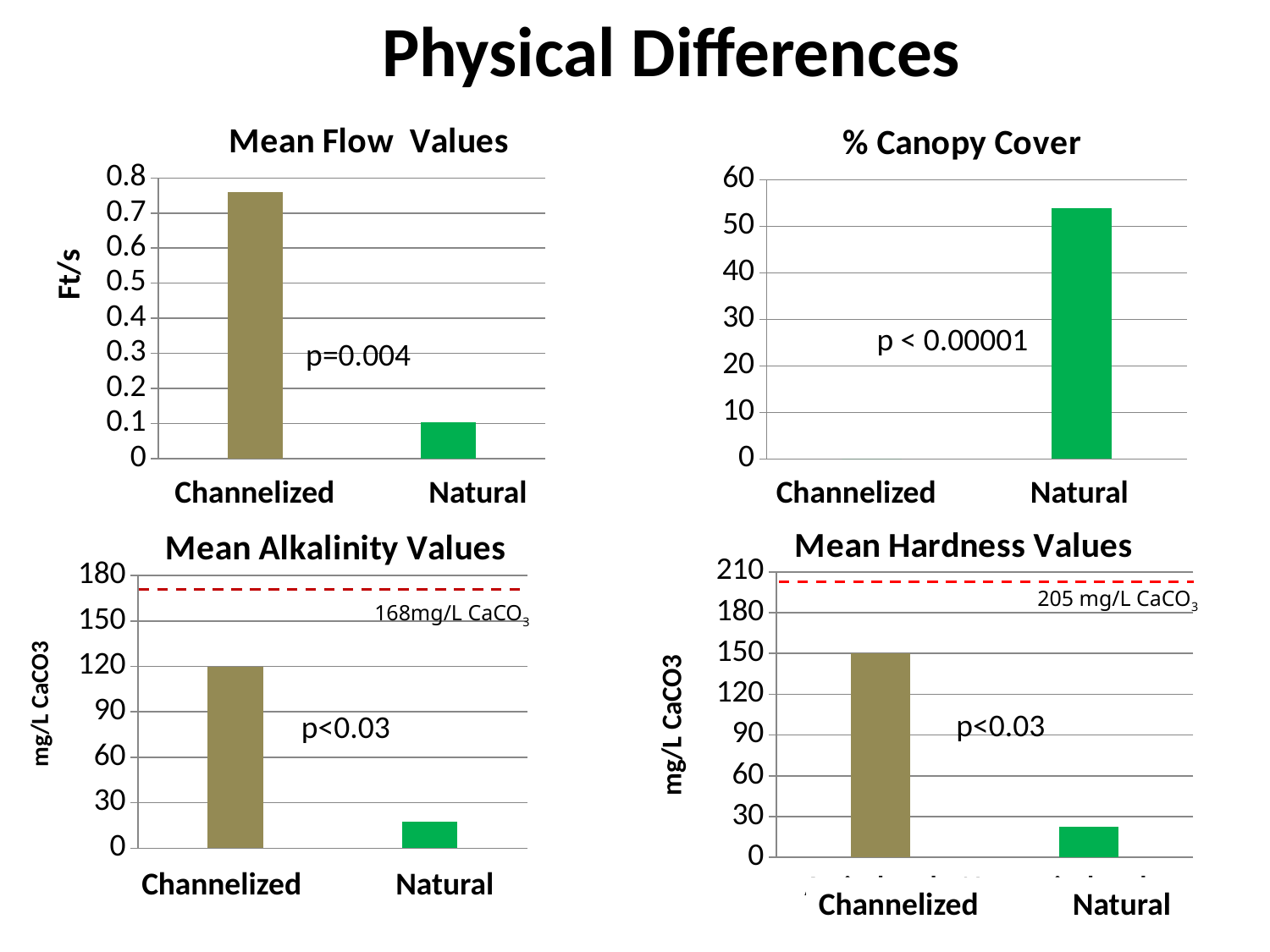
In the Mean Flow Values chart, is the value for Channelized greater or less than 0.7? greater How many charts are shown on the slide? 4 In the Mean Hardness Values chart, which category has the lower value? Natural In the % Canopy Cover chart, which category has the higher value? Natural What type of chart is the Mean Hardness Values chart? bar chart In the Mean Alkalinity Values chart, is the value for Natural greater or less than 30? less In the % Canopy Cover chart, is the value for Natural greater or less than 50? greater What value is labelled on the dashed red line in the Mean Alkalinity Values chart? 168mg/L CaCO3 In the Mean Flow Values chart, which category has the higher value? Channelized